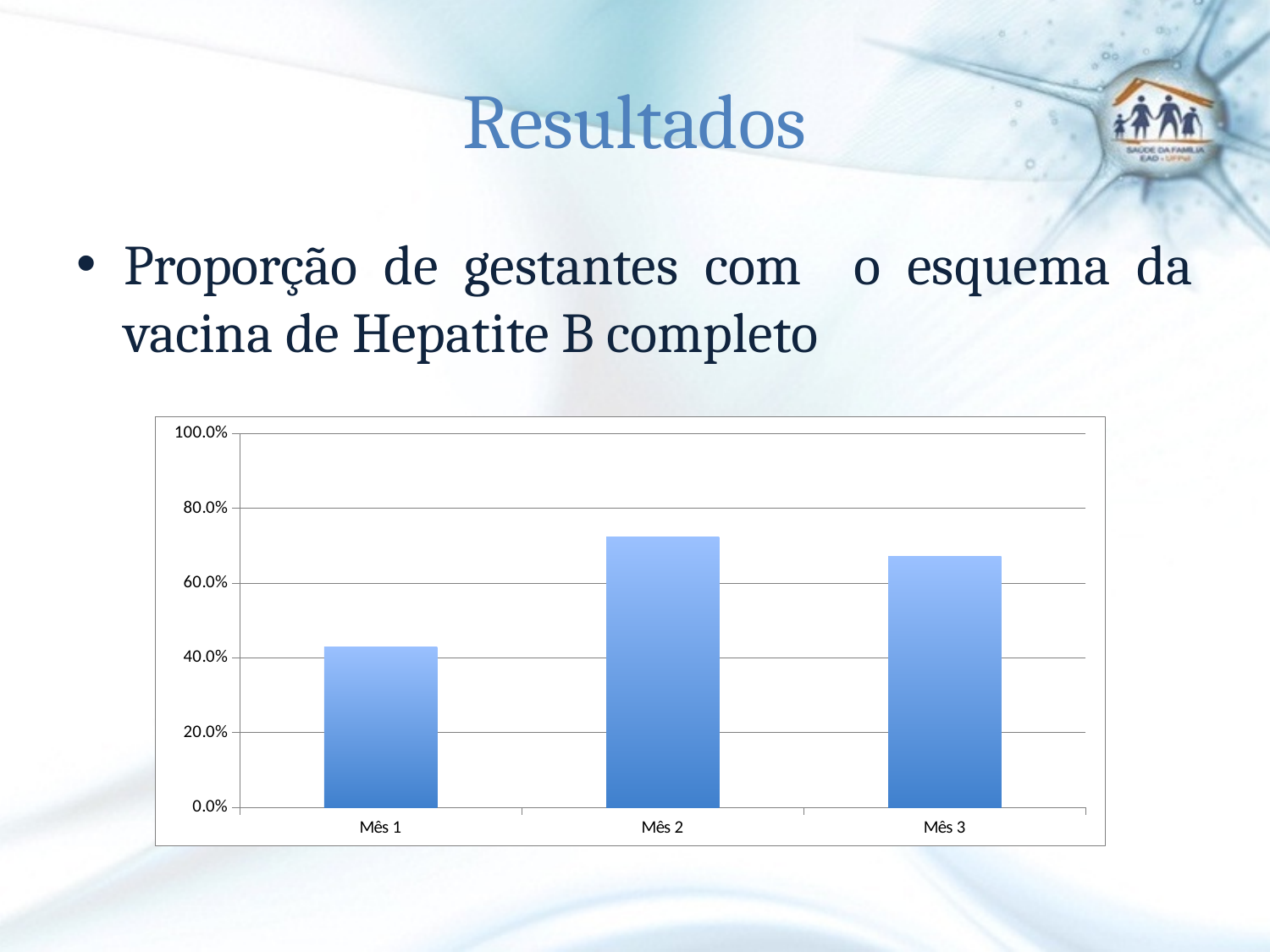
Does the value rise or fall from Mês 1 to Mês 2? rise Is the value for Mês 1 greater or less than 60.0%? less Is the value for Mês 1 greater or less than 40.0%? greater Is the value for Mês 3 greater or less than 60.0%? greater What kind of chart is shown on the slide? bar chart Which month has the highest value in the chart? Mês 2 What is the label of the first category on the x axis? Mês 1 Which is larger, the value for Mês 1 or the value for Mês 3? Mês 3 Which month has the lowest value in the chart? Mês 1 How many categories are shown on the x axis of the chart? 3